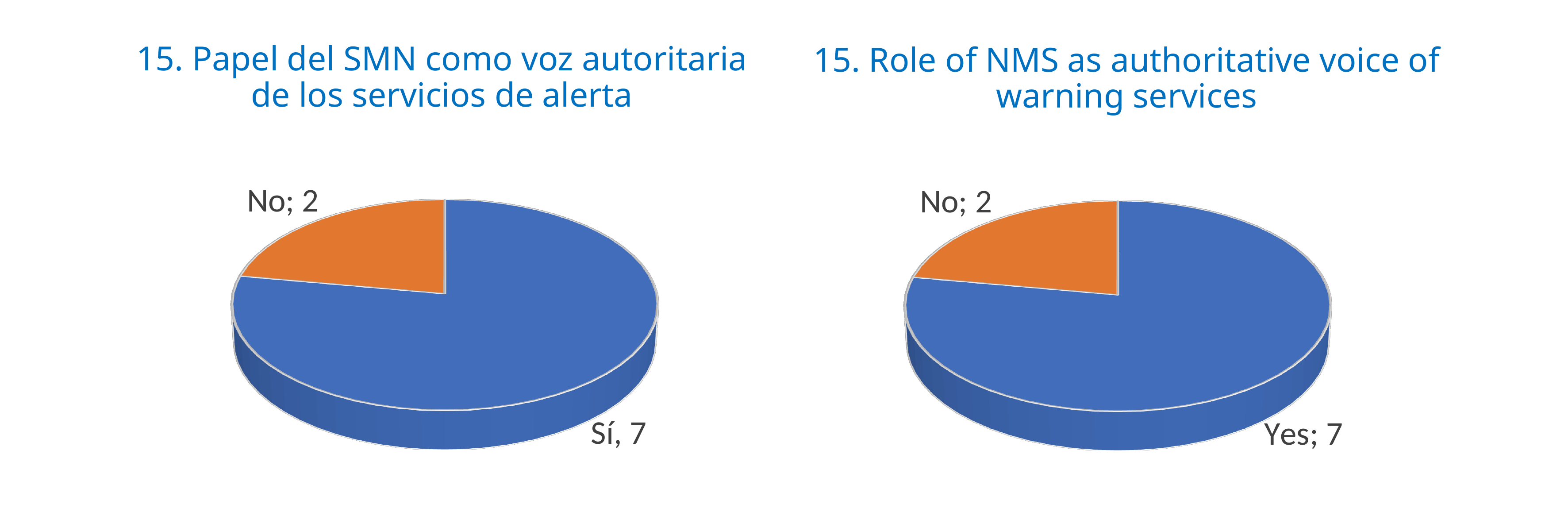
In the left chart (15. Papel del SMN como voz autoritaria de los servicios de alerta), what colour is the Sí slice? Blue In the right chart (15. Role of NMS as authoritative voice of warning services), how many slices does the pie have? 2 In the left chart (15. Papel del SMN como voz autoritaria de los servicios de alerta), what is the value for No? 2 In the left chart (15. Papel del SMN como voz autoritaria de los servicios de alerta), what is the value for Sí? 7 In the left chart (15. Papel del SMN como voz autoritaria de los servicios de alerta), which is larger, Sí or No? Sí In the left chart (15. Papel del SMN como voz autoritaria de los servicios de alerta), which category has the smallest slice? No What kind of chart is the left chart (15. Papel del SMN como voz autoritaria de los servicios de alerta)? Pie chart In the right chart (15. Role of NMS as authoritative voice of warning services), what is the value for No? 2 In the right chart (15. Role of NMS as authoritative voice of warning services), what share of the total does the No slice represent? 2 out of 9 In the right chart (15. Role of NMS as authoritative voice of warning services), which category has the largest slice? Yes In the right chart (15. Role of NMS as authoritative voice of warning services), what is the difference between the Yes and No values? 5 In the right chart (15. Role of NMS as authoritative voice of warning services), what is the value for Yes? 7